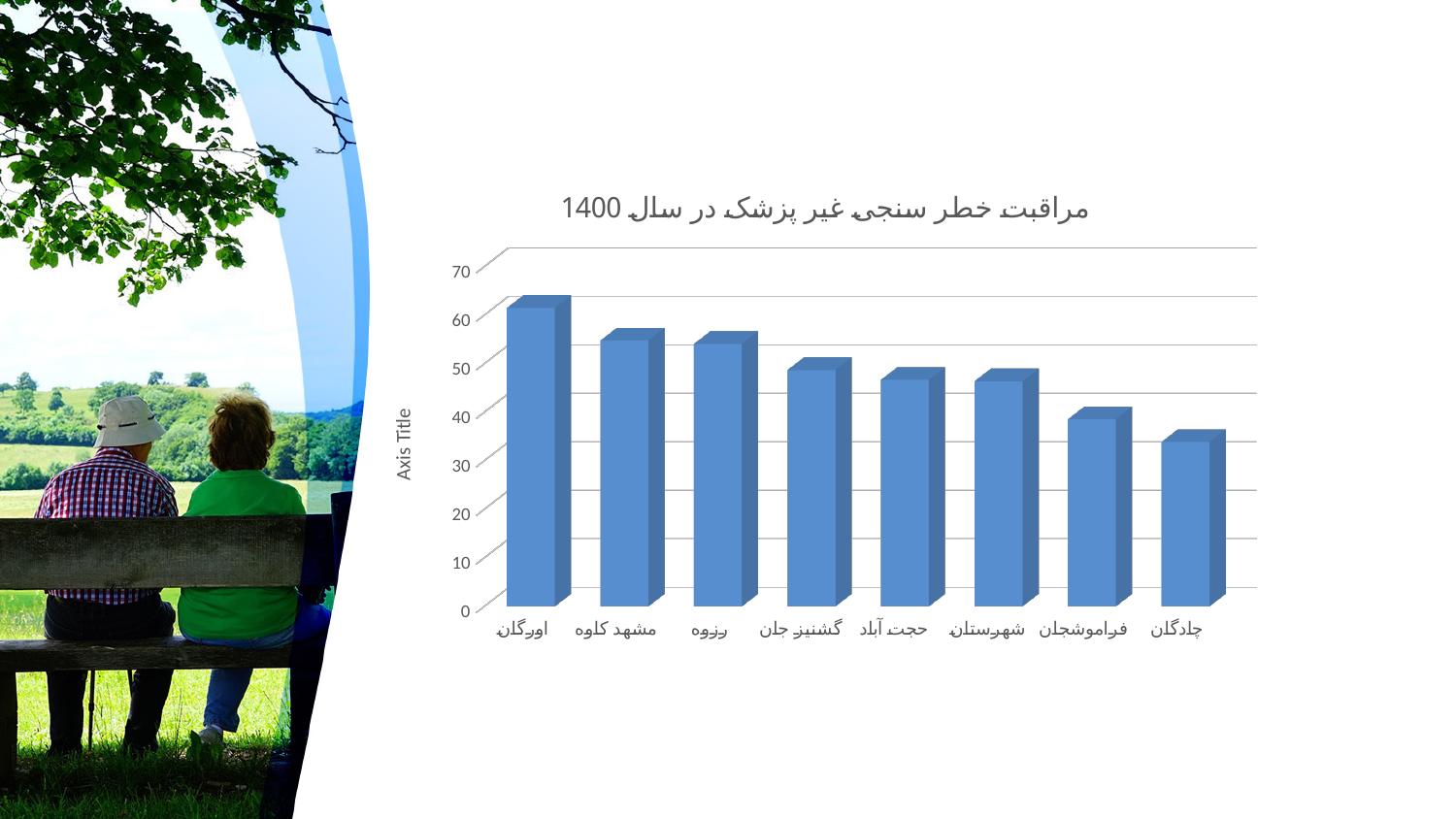
What text is shown as the vertical axis title of the chart? Axis Title What kind of chart is shown on the slide? Bar chart Which category has the highest value in the chart? اورگان Which is larger, the value for مشهد کلوه or the value for فراموشجان? مشهد کاوه Is the value for چادگان greater or less than 40? less What is the title of the chart? مراقبت خطر سنجی غیر پزشک در سال 1400 Is the value for اوریگان greater or less than 60? greater Which category has the lowest value in the chart? چادگان Is the value for فراموشجان greater or less than 30? greater How many categories are shown on the x axis of the chart? 8 Do the values generally rise or fall moving from اوریگان on the left to چادگان on the right? fall